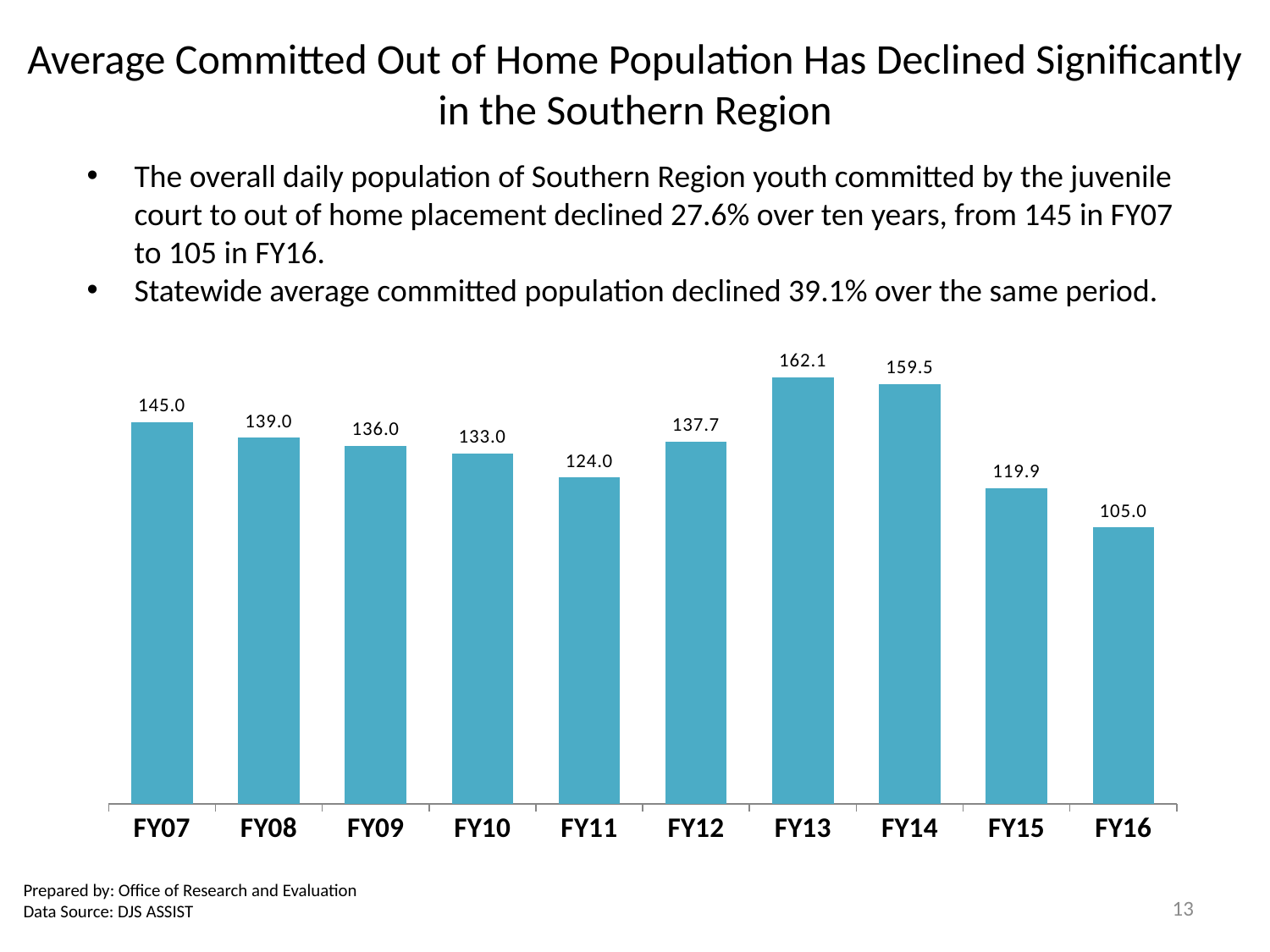
What is the value for FY13? 162.1 How many fiscal years are shown on the x axis? 10 What is the difference between the values for FY07 and FY16? 40.0 Do the values rise or fall from FY14 to FY16? Fall Which fiscal year has the lowest value? FY16 What is the value for FY07? 145.0 What is the value for FY16? 105.0 Which is larger, the value for FY12 or the value for FY15? FY12 What kind of chart is shown on the slide? Bar chart What is the difference between the values for FY13 and FY14? 2.6 What is the value for FY11? 124.0 Which fiscal year has the highest value? FY13